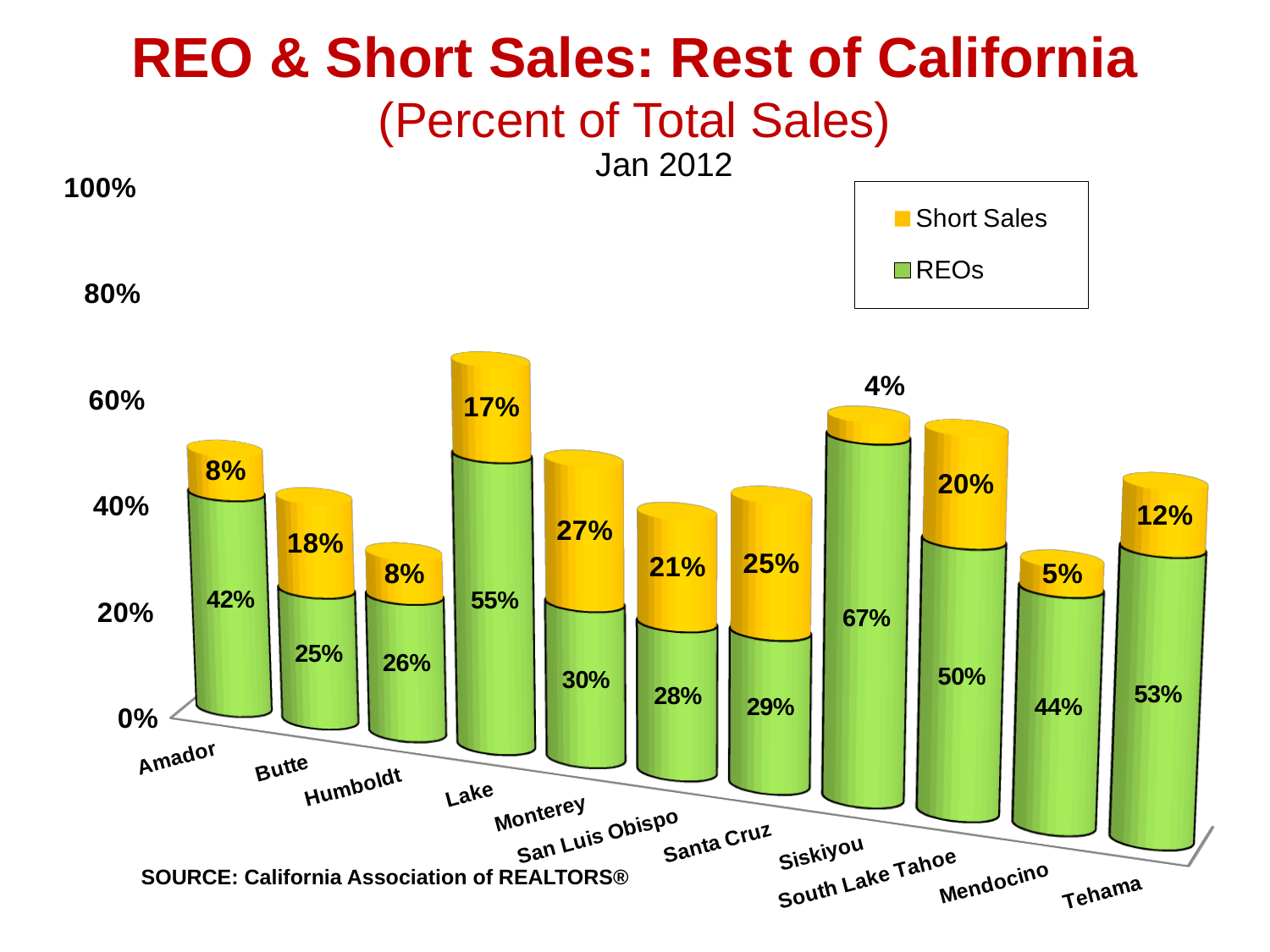
Which county has the highest REOs percentage? Siskiyou What is the REOs value for Siskiyou? 67% Which month and year does the chart cover? Jan 2012 How many counties are shown on the x axis? 11 Which county has the lowest Short Sales percentage? Siskiyou How many series does the legend list? 2 Which is larger, the Short Sales value for Santa Cruz or the Short Sales value for Tehama? Santa Cruz What is the difference between the REOs values for Lake and Butte? 30% What kind of chart is shown on the slide? Stacked bar chart What is the combined REOs and Short Sales total for Lake? 72% What is the Short Sales value for Monterey? 27% What is the combined REOs and Short Sales total for South Lake Tahoe? 70%